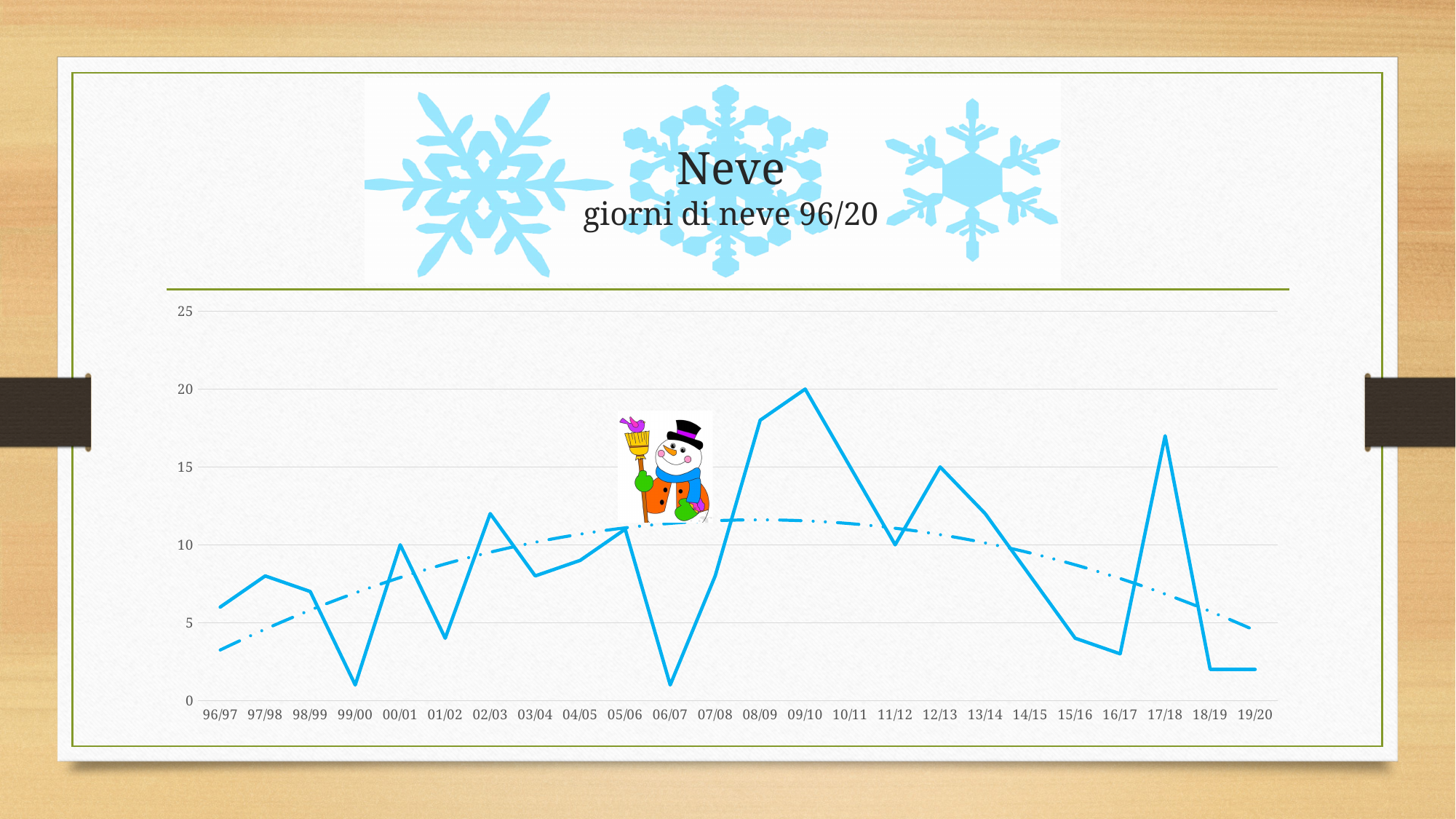
Is the value for 02/03 greater or less than 10? greater What is the value for 09/10? 20 Do the values rise or fall from 17/18 to 18/19? fall What is the subtitle of the chart? giorni di neve 96/20 Which is larger, the value for 08/09 or the value for 15/16? 08/09 Which season has the highest number of snow days? 09/10 What is the value for 11/12? 10 How many seasons are shown on the x axis? 24 Is the value for 17/18 greater or less than 15? greater What kind of chart is shown on the slide? line chart What is the value for 12/13? 15 Is the value for 99/00 greater or less than 5? less